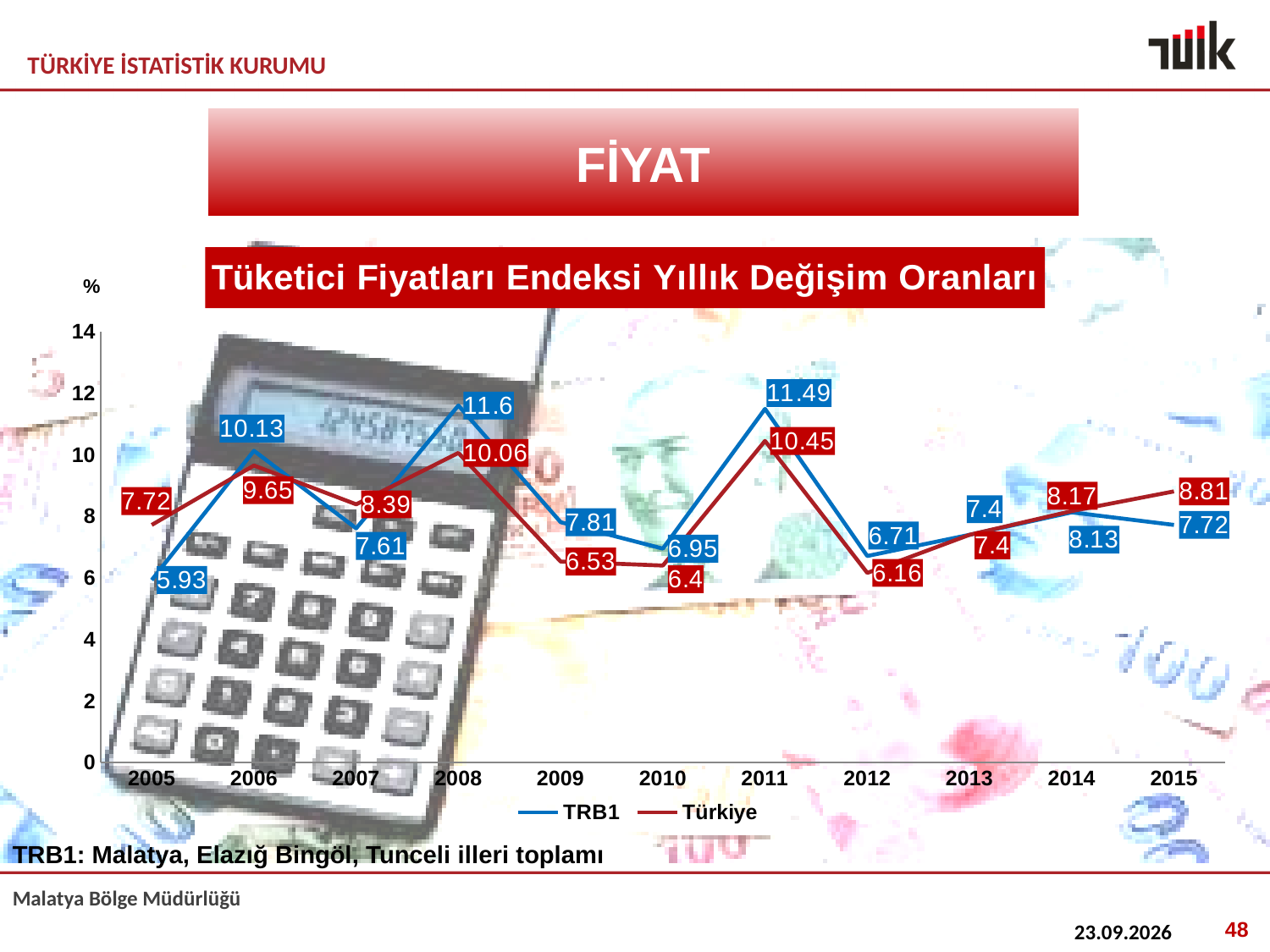
What is the title of the chart? Tüketici Fiyatları Endeksi Yıllık Değişim Oranları How many years are shown on the x axis? 11 How many series does the legend list? 2 What is the difference between the TRB1 and Türkiye values in 2011? 1.04 What is the TRB1 value for 2008? 11.6 What type of chart is shown on the slide? line chart In which year is the TRB1 series highest? 2008 Does the Türkiye series rise or fall from 2012 to 2015? rise In 2015, which series has the larger value, TRB1 or Türkiye? Türkiye What is the Türkiye value for 2011? 10.45 In which year is the Türkiye series lowest? 2012 What is the TRB1 value for 2005? 5.93